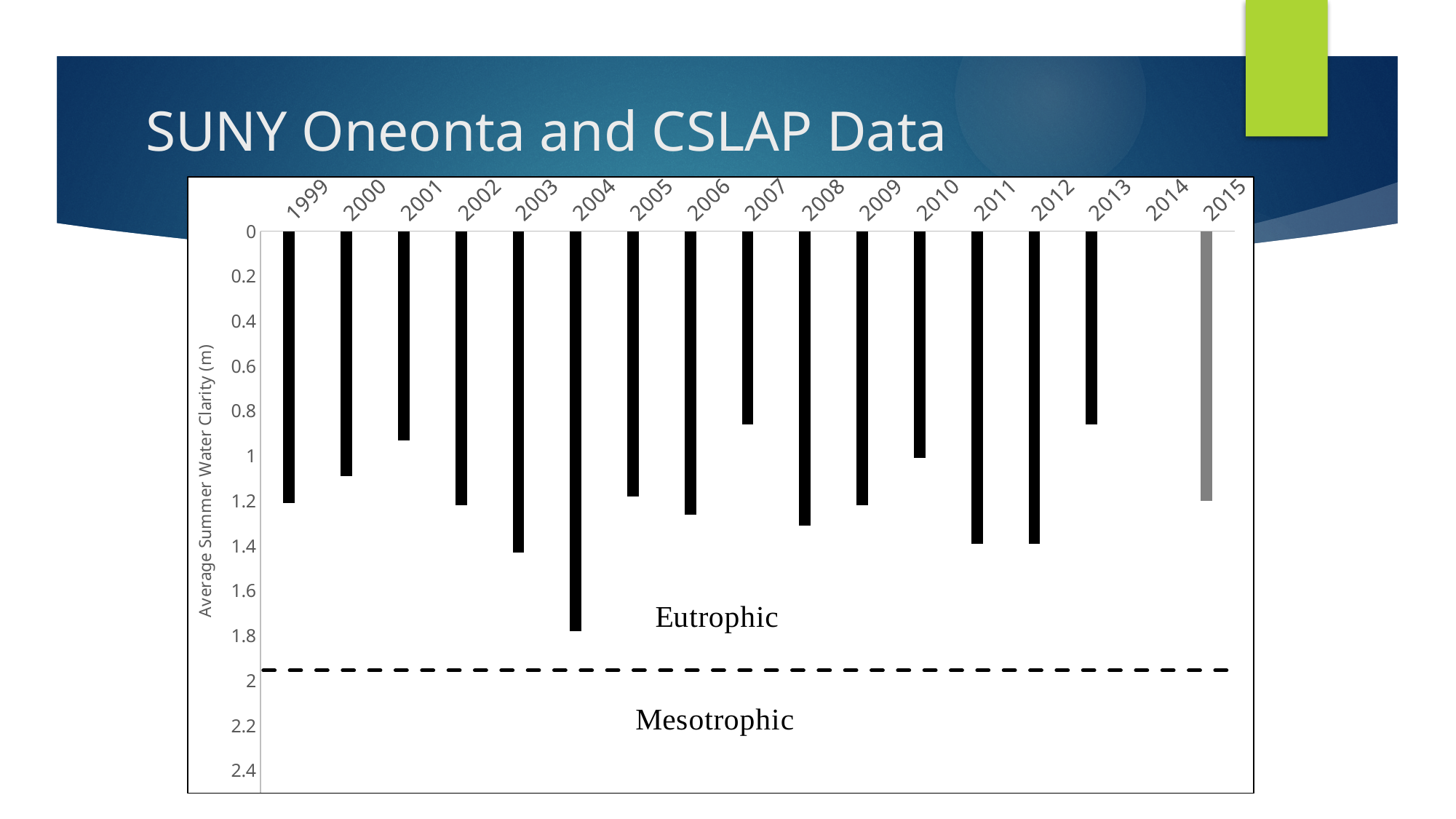
Which year on the x axis has no bar plotted? 2014 What is the title of the y axis? Average Summer Water Clarity (m) Is the value for 2011 greater or less than 1.2? greater How many years are labelled on the x axis? 17 What kind of chart is shown on the slide? bar chart Is the value for 2007 greater or less than 1? less Is the value for 2003 greater or less than 1.2? greater Which has the larger average summer water clarity value, 2003 or 2000? 2003 Which year has the largest average summer water clarity value? 2004 Which has the larger average summer water clarity value, 2004 or 2001? 2004